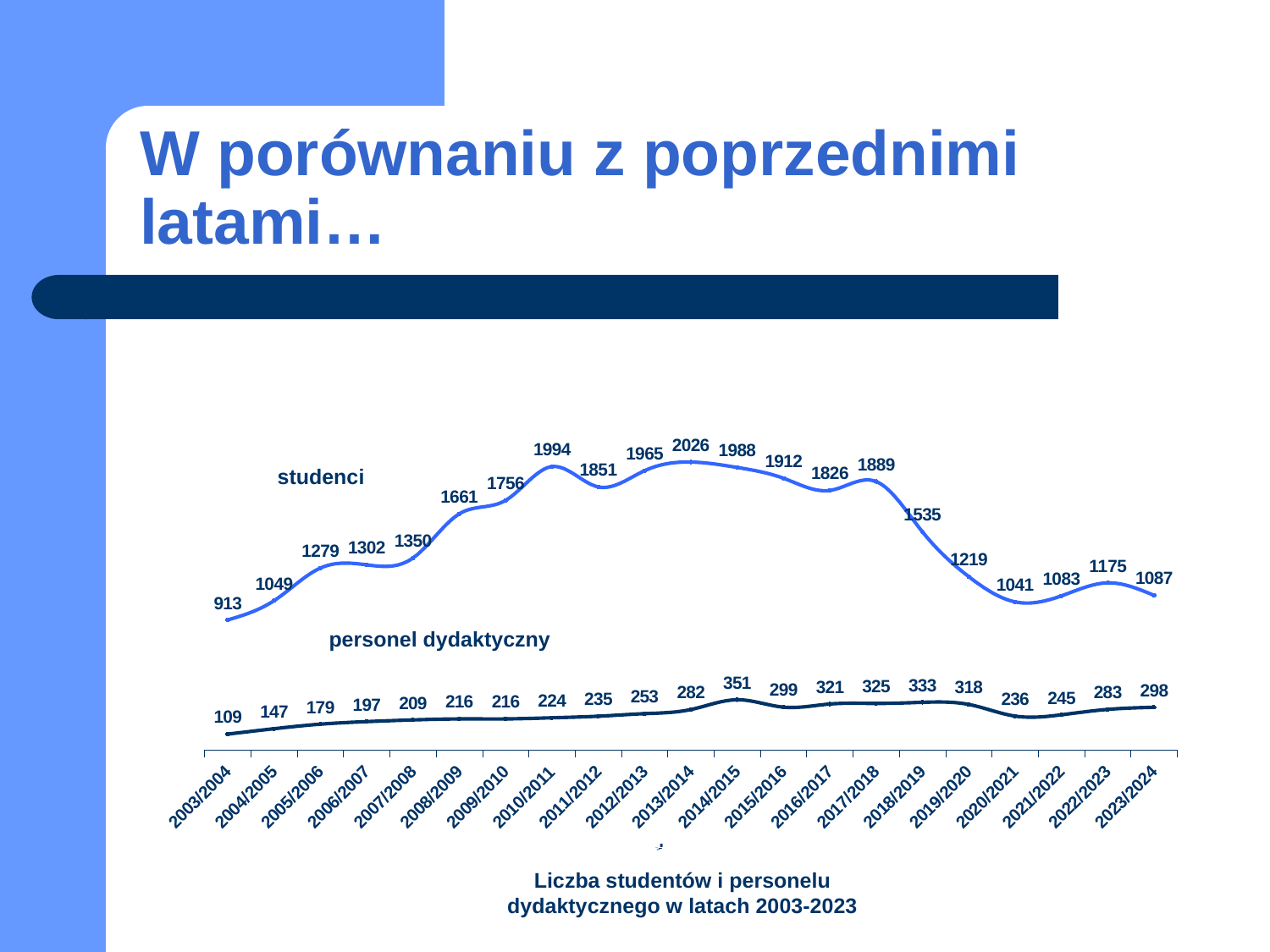
In which academic year is the personel dydaktyczny value lowest? 2003/2004 What is the value for studenci in 2023/2024? 1087 What is the value for studenci in 2003/2004? 913 How many academic years are plotted on the x axis? 21 In which academic year is the studenci value highest? 2013/2014 What type of chart is shown on the slide? line chart How many data series does the chart show? 2 What is the difference between the highest studenci value (2026) and the lowest studenci value (913)? 1113 By how much did personel dydaktyczny increase from 2003/2004 (109) to 2023/2024 (298)? 189 Which is larger: the studenci value in 2019/2020 or in 2022/2023? 2019/2020 What is the value for personel dydaktyczny in 2014/2015? 351 What is the caption/title of the chart? Liczba studentów i personelu dydaktycznego w latach 2003-2023